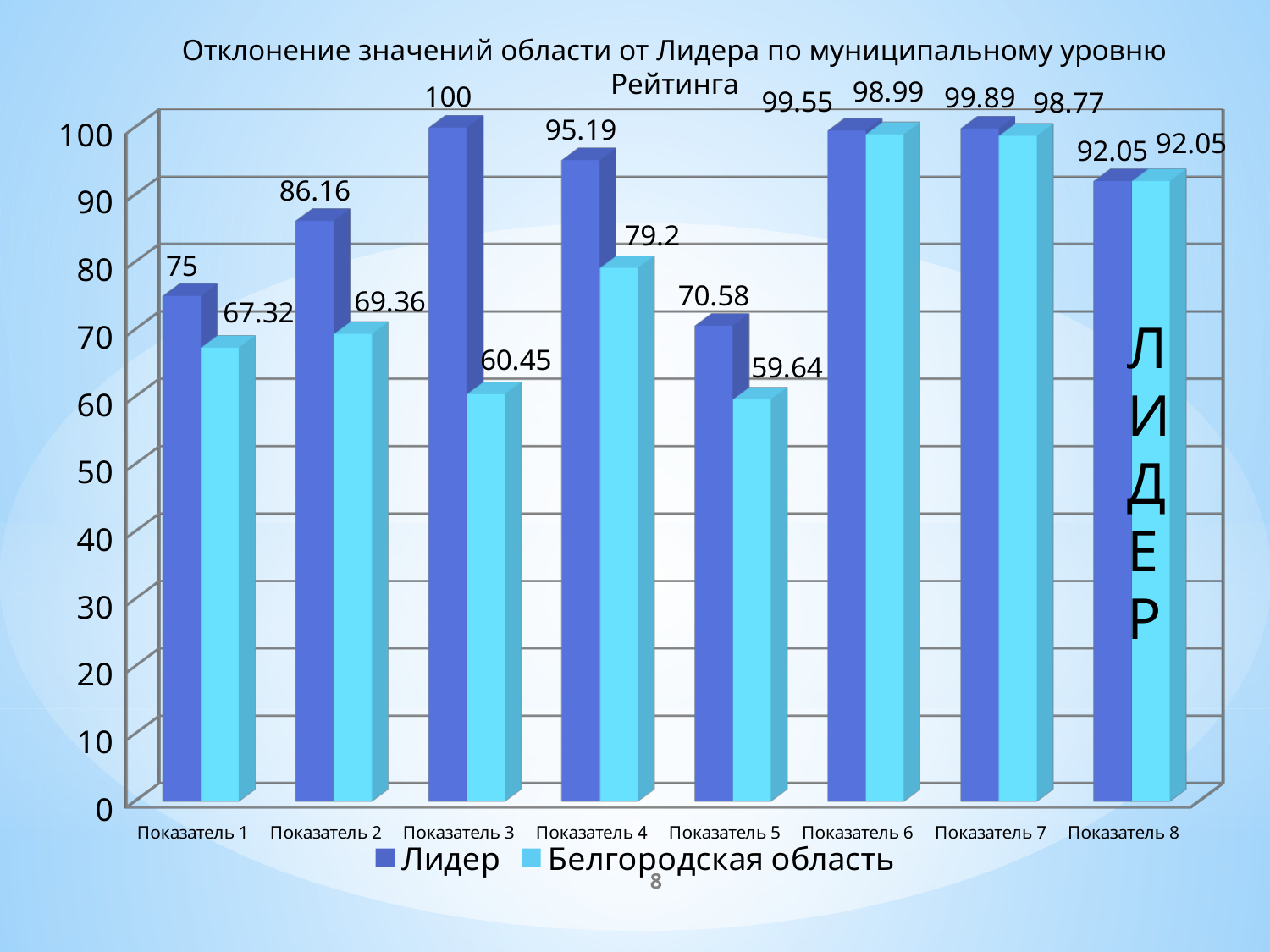
What kind of chart is shown on the slide? bar chart How many categories are shown on the x axis? 8 Which category has the lowest value for Белгородская область? Показатель 5 Which is larger at Показатель 1: Лидер or Белгородская область? Лидер How many series does the legend list? 2 Which category has the highest value for Лидер? Показатель 3 Which series is shown in light blue in the legend? Белгородская область What is the value for Белгородская область at Показатель 4? 79.2 What is the difference between Лидер and Белгородская область at Показатель 3? 39.55 Is the value for Белгородская область at Показатель 2 greater or less than 60? greater What is the value for Лидер at Показатель 2? 86.16 What is the value for Белгородская область at Показатель 5? 59.64